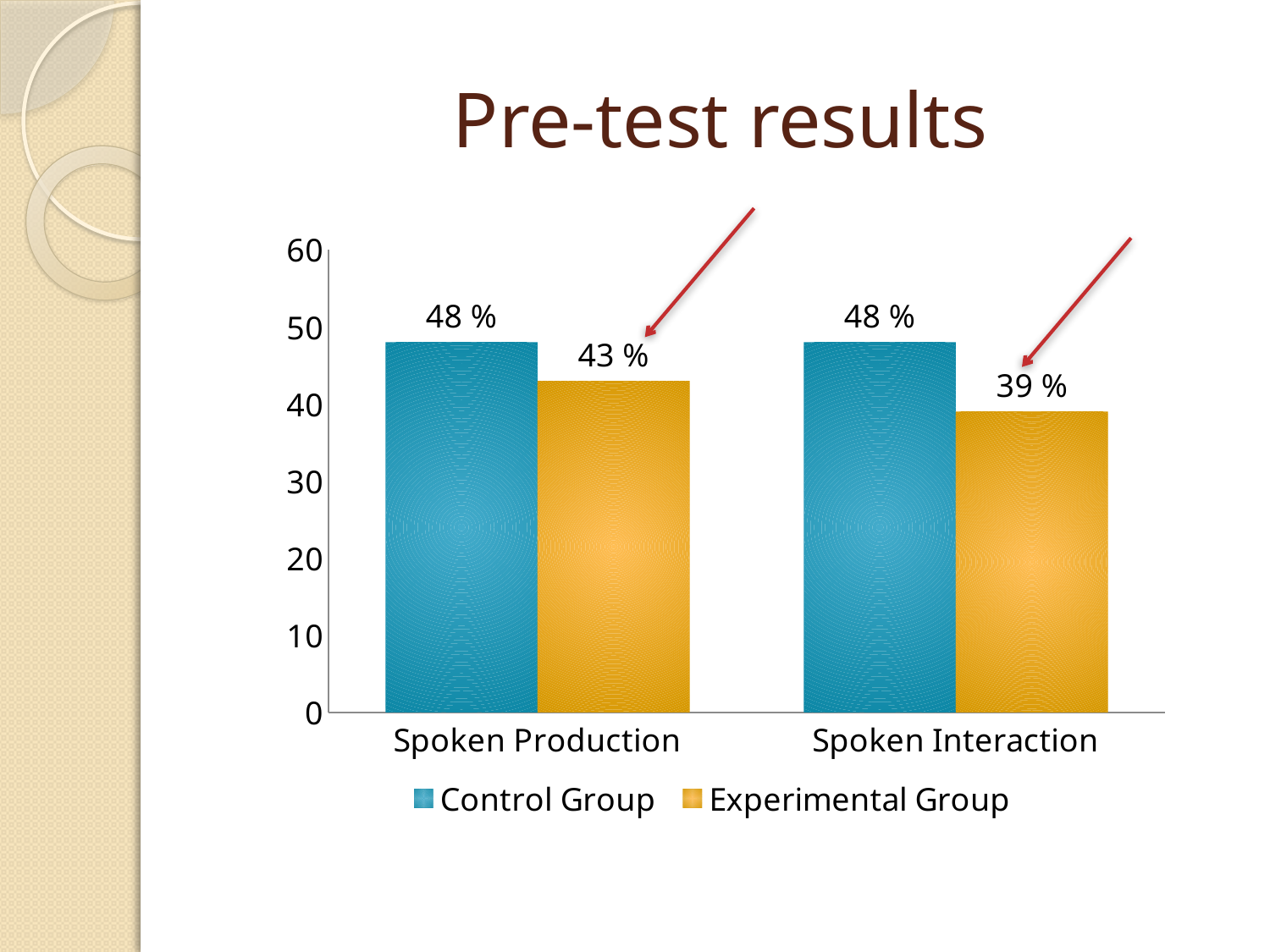
What is the value for the Control Group in Spoken Production? 48 % How many series does the legend list? 2 Which group has the larger value in Spoken Production, the Control Group or the Experimental Group? Control Group What is the value for the Experimental Group in Spoken Interaction? 39 % What is the difference between the Control Group and Experimental Group values in Spoken Interaction? 9 % How many categories are shown on the x axis? 2 What is the difference between the Control Group and Experimental Group values in Spoken Production? 5 % Which category has the lowest Experimental Group value? Spoken Interaction Is the Experimental Group value for Spoken Interaction greater or less than 40? less What is the value for the Experimental Group in Spoken Production? 43 % What kind of chart is shown on the slide? bar chart What is the value for the Control Group in Spoken Interaction? 48 %